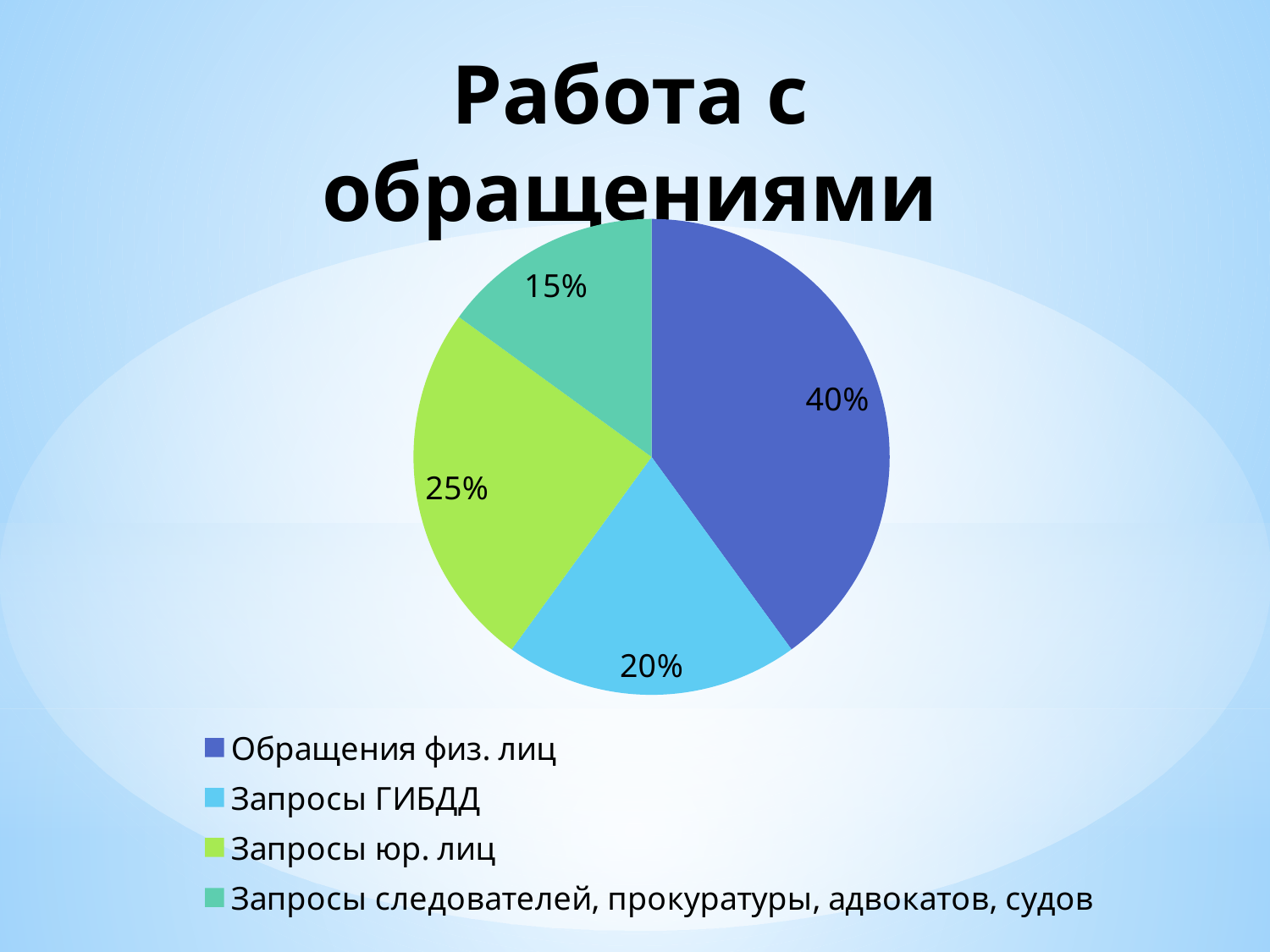
Which category has the smallest slice of the pie? Запросы следователей, прокуратуры, адвокатов, судов Which is larger: the share for Запросы юр. лиц or the share for Запросы ГИБДД? Запросы юр. лиц What colour is the slice for Запросы юр. лиц? Green How many categories are shown in the pie chart? 4 Which category has the largest slice of the pie? Обращения физ. лиц What share of the pie does Обращения физ. лиц represent? 40% What is the value shown for Запросы ГИБДД? 20% What is the value shown for Запросы юр. лиц? 25% What is the difference between the shares of Обращения физ. лиц and Запросы ГИБДД? 20% What is the value shown for Запросы следователей, прокуратуры, адвокатов, судов? 15% What kind of chart is shown on the slide? Pie chart What is the title of the chart? Работа с обращениями